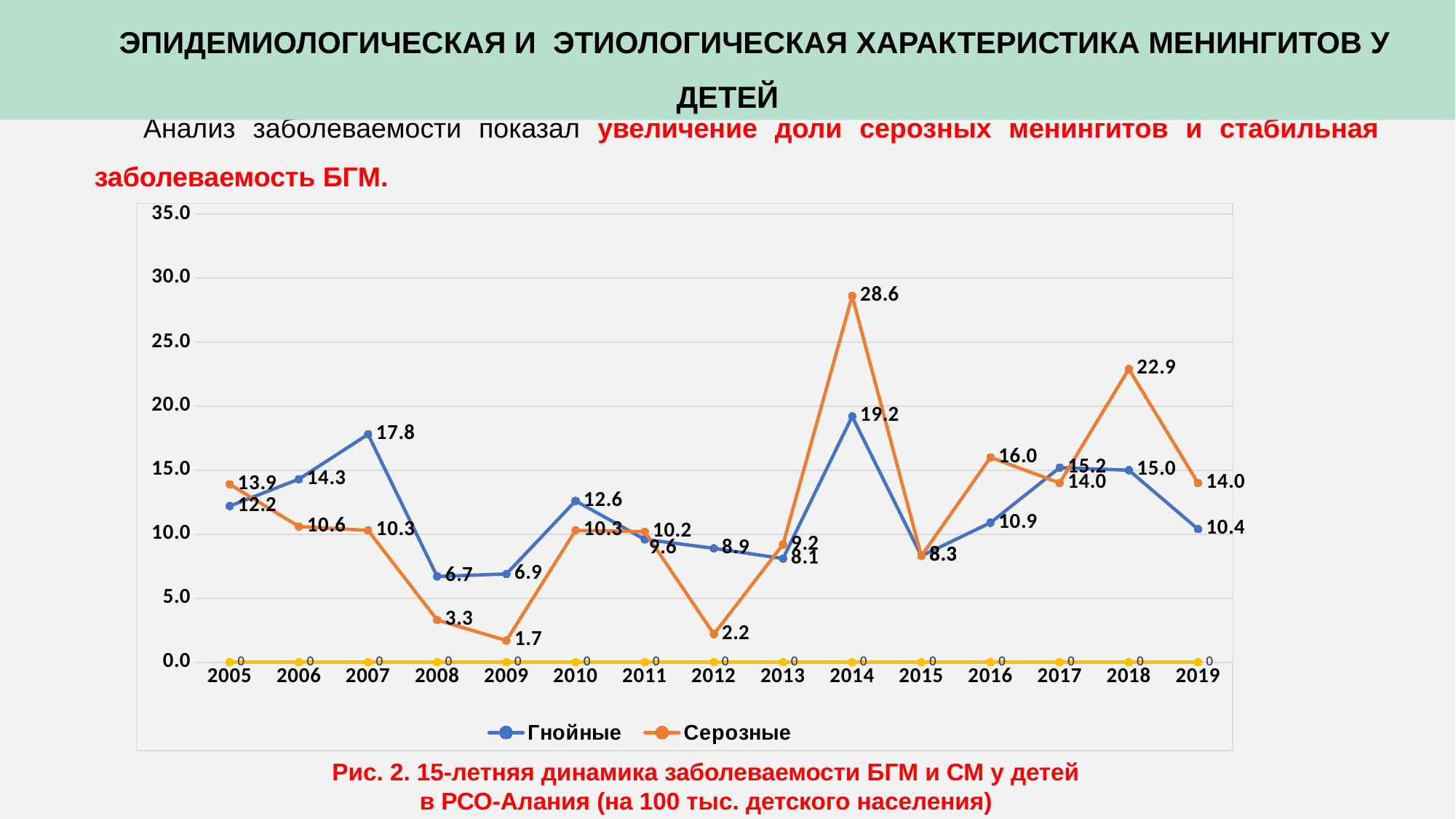
How many series does the legend list? 2 In which year is the Серозные series lowest? 2009 In 2005, which series has the larger value, Гнойные or Серозные? Серозные By how much did the Гнойные value fall from 2007 to 2008? 11.1 What is the value for Серозные in 2018? 22.9 What is the value for Гнойные in 2007? 17.8 How many years are plotted on the x axis? 15 What is the value for Серозные in 2014? 28.6 What kind of chart is shown on the slide? Line chart What is the difference between the Серозные and Гнойные values in 2014? 9.4 In which year is the Гнойные series highest? 2014 In which year is the Серозные series highest? 2014